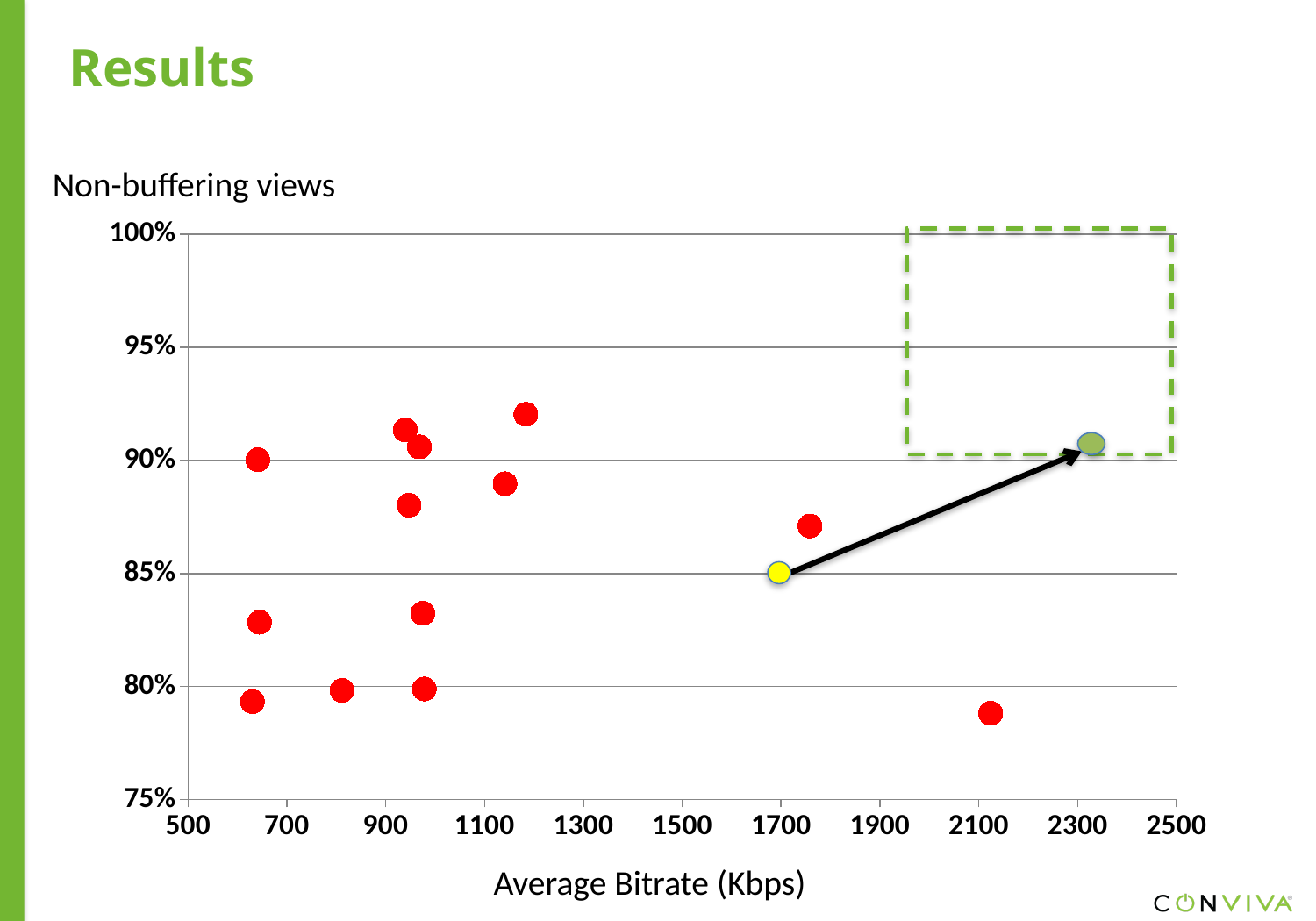
Is the non-buffering views value for the green point near 2300 Kbps greater or less than 90%? greater What kind of chart is shown on the slide? scatter chart What is the label of the y axis? Non-buffering views Is the non-buffering views value for the red point near 1750 Kbps greater or less than 85%? greater Which has a higher non-buffering views value, the yellow point or the green point? the green point Is the non-buffering views value for the red point near 1200 Kbps greater or less than 90%? greater What is the non-buffering views value of the yellow point at 1700 Kbps? 85% What is the label of the x axis? Average Bitrate (Kbps) Which point has the highest average bitrate on the chart? the green point How many red data points are plotted on the chart? 13 Which has a higher non-buffering views value, the red point near 1750 Kbps or the red point near 2100 Kbps? the red point near 1750 Kbps